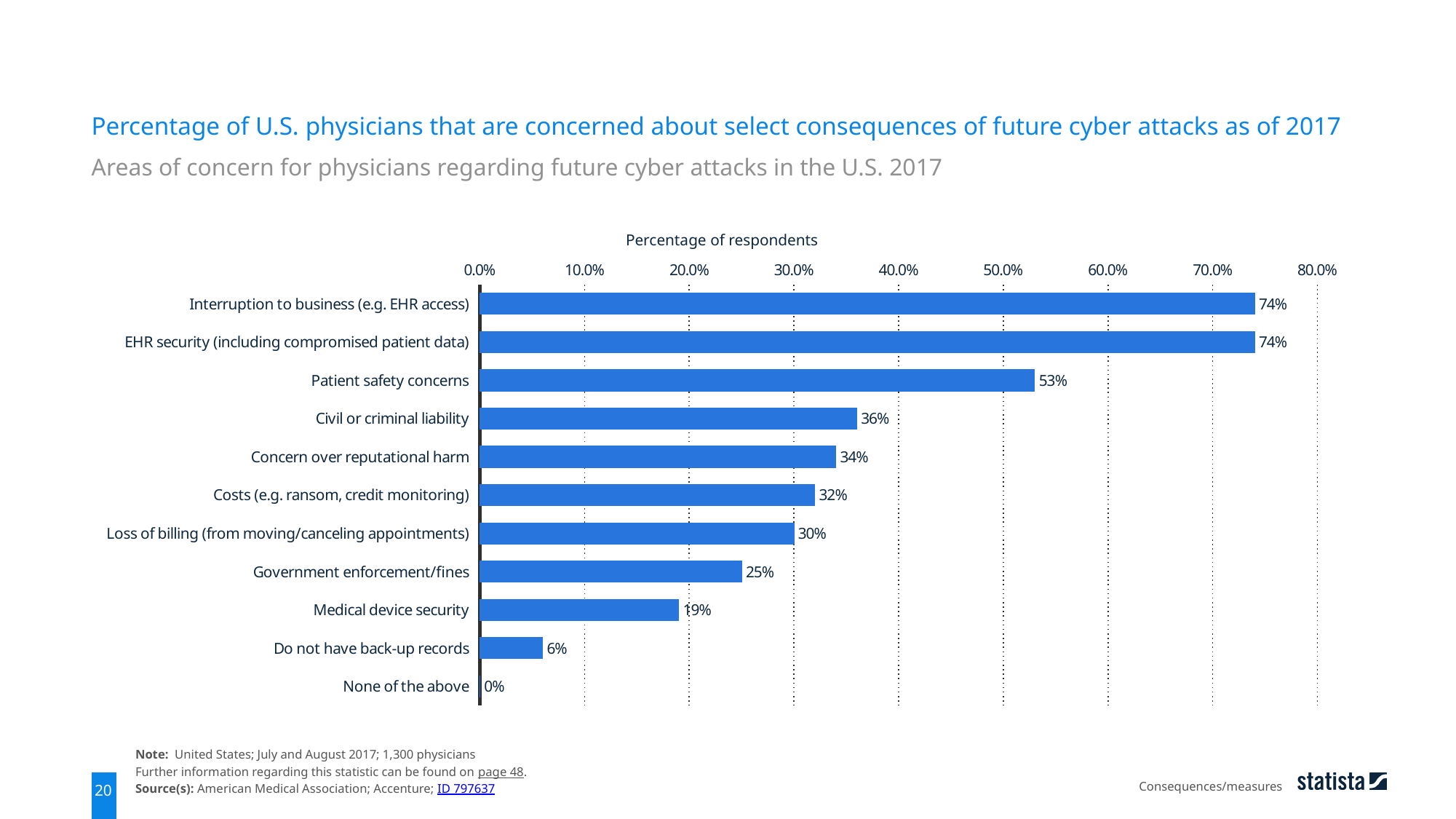
What value is shown for Do not have back-up records? 6% Which is larger: Costs (e.g. ransom, credit monitoring) or Do not have back-up records? Costs (e.g. ransom, credit monitoring) What kind of chart is shown on the slide? Bar chart What percentage of physicians are concerned about patient safety concerns? 53% What is the difference between Civil or criminal liability and Concern over reputational harm? 2% What is the value for Medical device security? 19% What is the difference between Patient safety concerns and Loss of billing (from moving/canceling appointments)? 23% Which category has the lowest value? None of the above What is the label of the horizontal axis? Percentage of respondents How many categories are shown in the chart? 11 Is the value for Patient safety concerns greater or less than 50.0%? greater What percentage of respondents selected Government enforcement/fines? 25%